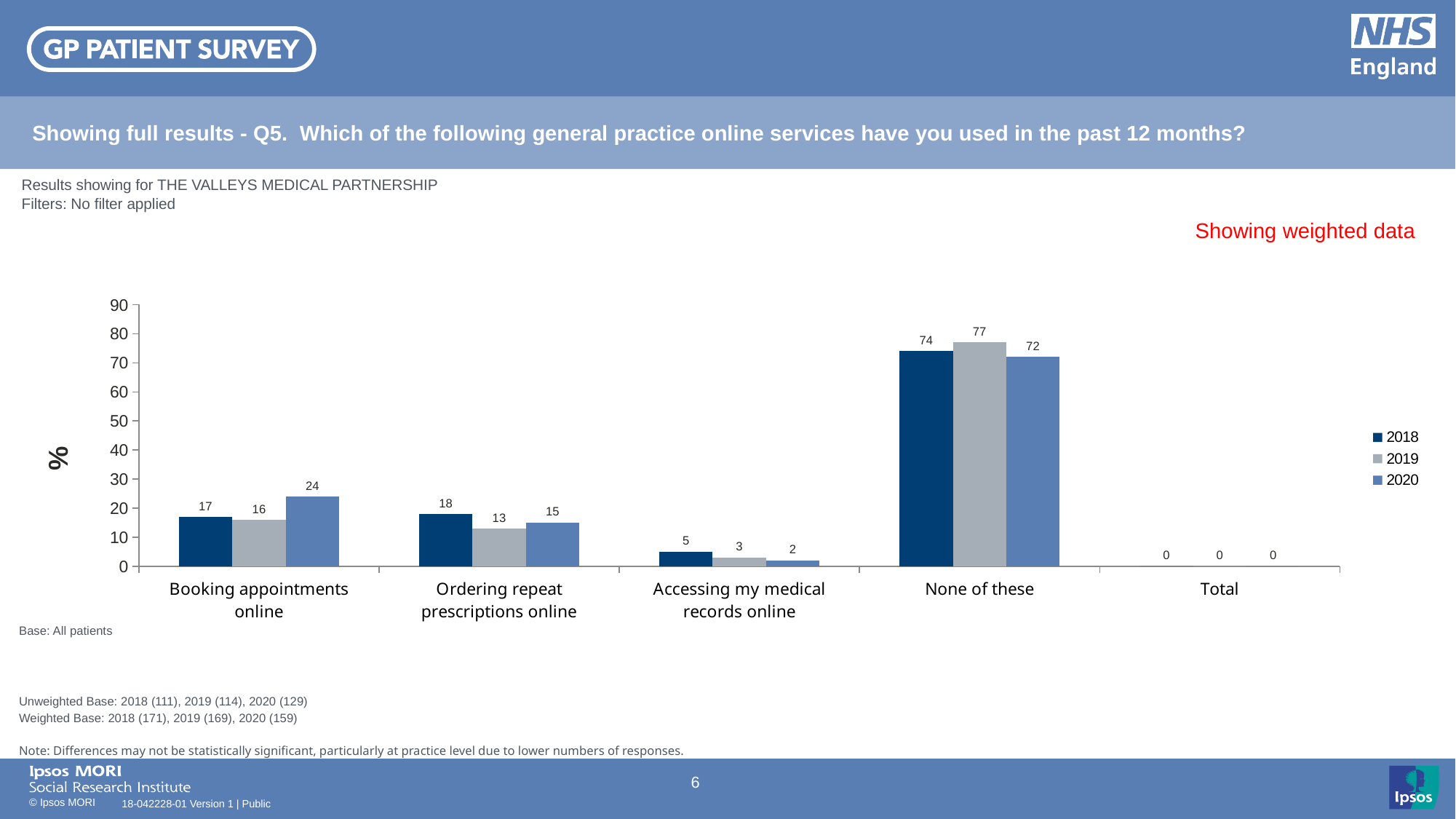
What is the value for 'None of these' in 2019? 77 Is the value for 'None of these' in 2018 greater or less than 70? greater What is the value for 'Accessing my medical records online' in 2018? 5 Which year has the lowest value for 'Ordering repeat prescriptions online'? 2019 What kind of chart is shown on the slide? Bar chart What label is shown on the y axis? % How many series does the legend list? 3 How many categories are shown on the x axis? 5 Which is larger for 'Booking appointments online': the 2018 value or the 2019 value? 2018 Which category has the highest value for 2020? None of these What is the value for 'Booking appointments online' in 2020? 24 What is the difference between the 2019 and 2020 values for 'None of these'? 5